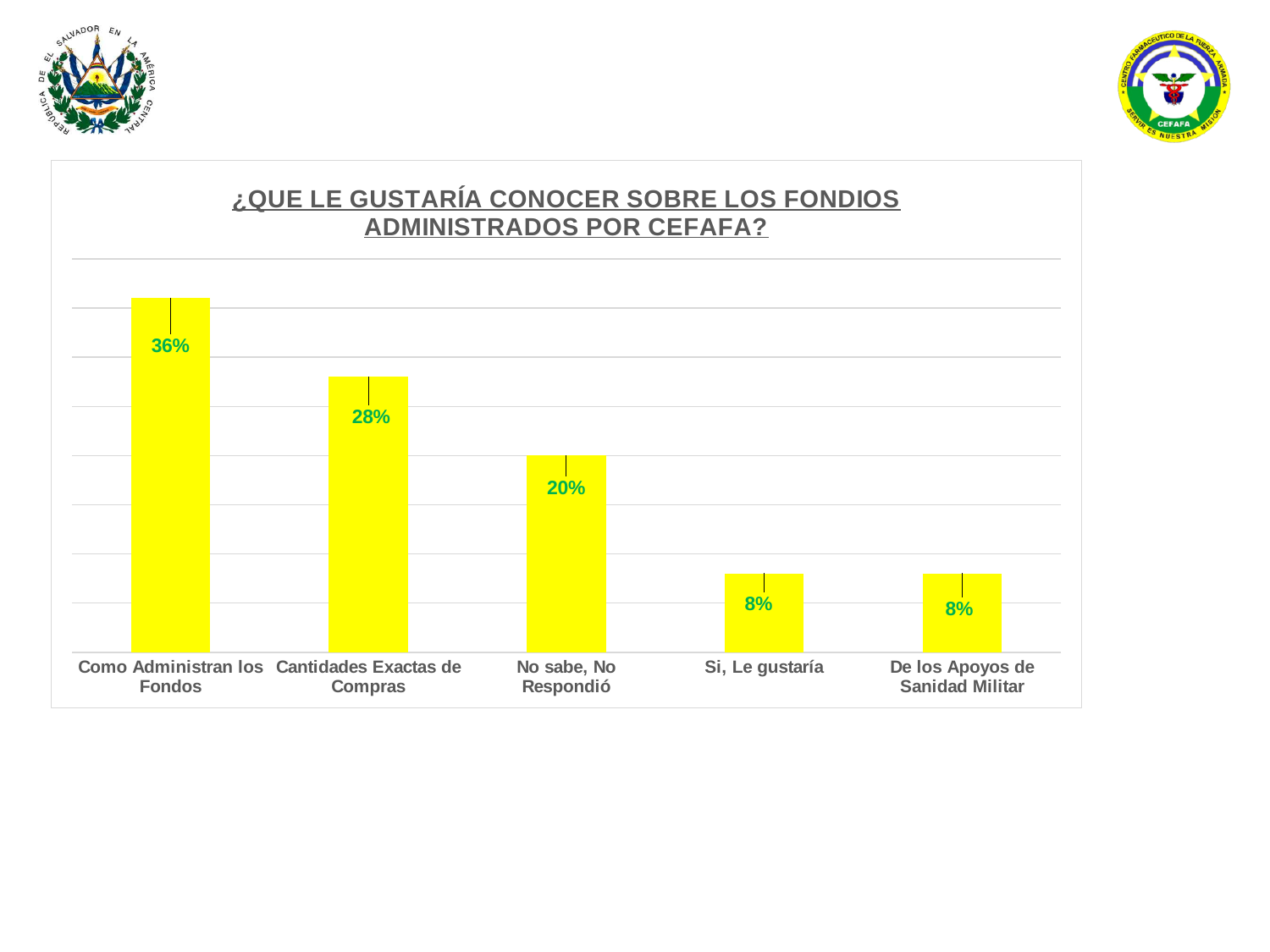
Do the values rise or fall from left to right across the categories? Fall What is the value for "Como Administran los Fondos"? 36% What is the difference between the values for "Cantidades Exactas de Compras" and "No sabe, No Respondió"? 8% What is the value for "Cantidades Exactas de Compras"? 28% How many categories are shown in the chart? 5 What is the difference between the values for "Como Administran los Fondos" and "Cantidades Exactas de Compras"? 8% What is the value for "No sabe, No Respondió"? 20% Which is larger, the value for "No sabe, No Respondió" or the value for "De los Apoyos de Sanidad Militar"? No sabe, No Respondió What is the title of the chart? ¿QUE LE GUSTARÍA CONOCER SOBRE LOS FONDIOS ADMINISTRADOS POR CEFAFA? Which category has the highest value? Como Administran los Fondos What kind of chart is shown on the slide? Bar chart What is the value for "Si, Le gustaría"? 8%